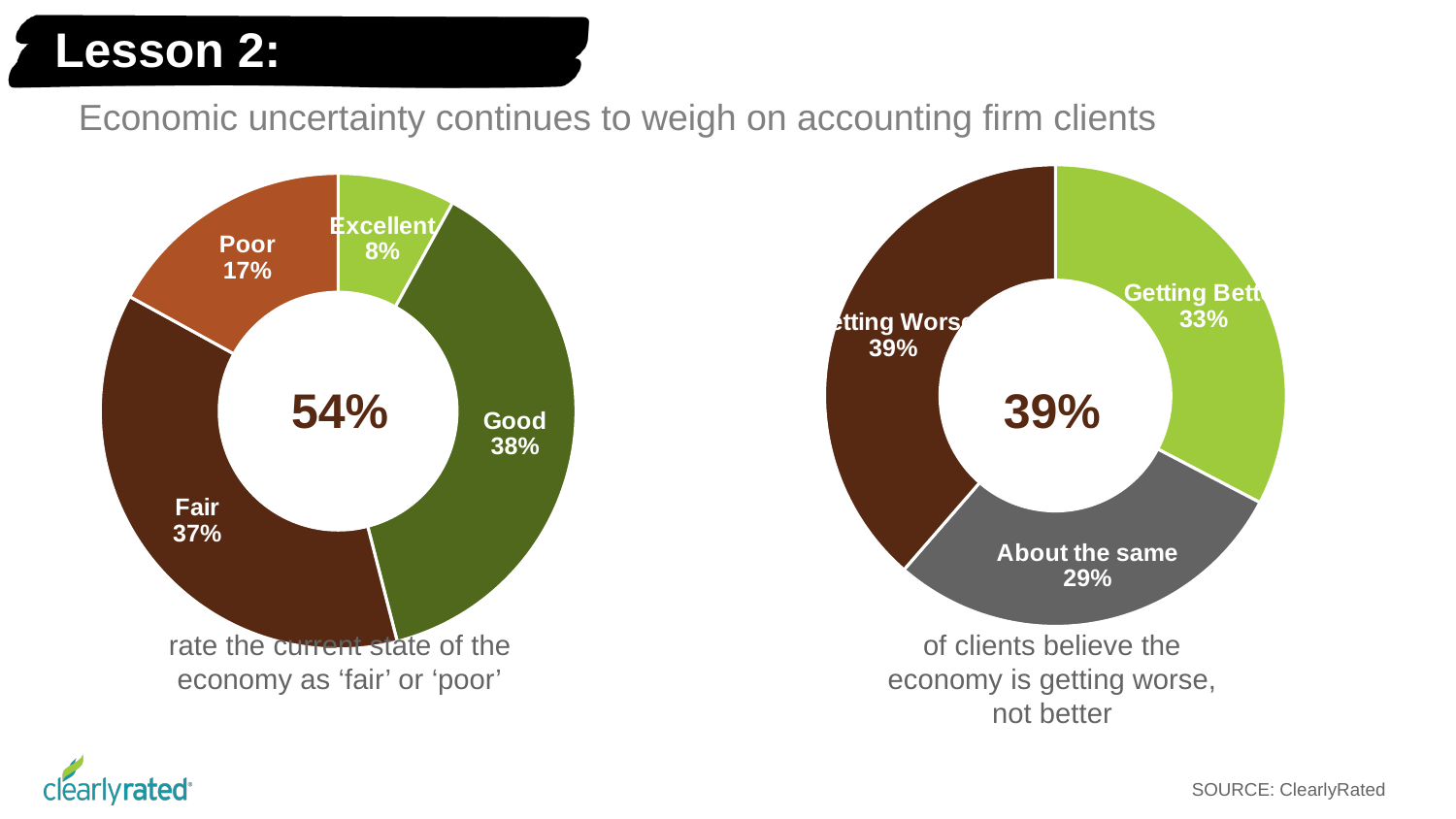
In the left chart (current state of the economy), what percentage of clients rate the economy as Good? 38% How many categories are shown in the left chart (current state of the economy)? 4 In the left chart (current state of the economy), what is the combined share of clients rating the economy as Fair or Poor? 54% In the right chart (economy direction), what percentage of clients believe the economy is about the same? 29% In the left chart (current state of the economy), how many percentage points larger is the Fair share than the Poor share? 20 What type of chart is used on this slide? Pie (donut) chart In the right chart (economy direction), how many percentage points separate Getting Better from About the same? 4 In the right chart (economy direction), what percentage of clients believe the economy is getting worse? 39% In the left chart (current state of the economy), which rating has the largest share? Good In the right chart (economy direction), which is larger: the share saying Getting Better or the share saying Getting Worse? Getting Worse In the left chart (current state of the economy), what percentage of clients rate the economy as Poor? 17% In the left chart (current state of the economy), which rating has the smallest share? Excellent